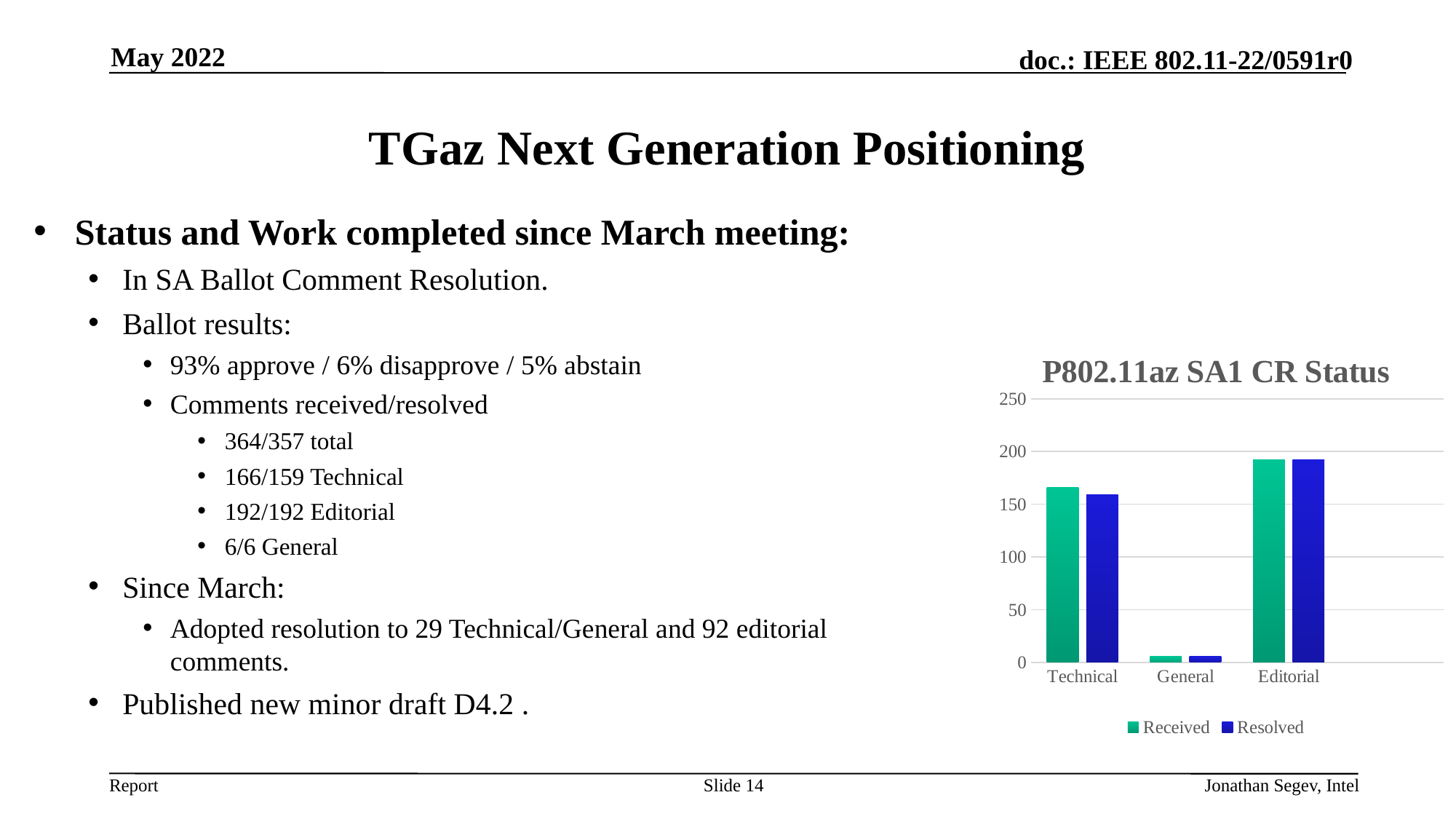
Which category has the lowest Resolved value? General What is the title of the chart? P802.11az SA1 CR Status Which is larger, the Received value for Technical or the Received value for Editorial? Editorial Which category has the highest Received value? Editorial Is the Received value for Technical greater or less than 150? greater How many categories are shown on the x axis of the chart? 3 How many series does the chart legend list? 2 Is the Received value for Editorial greater or less than 200? less Is the Resolved value for Editorial greater or less than 150? greater Which series is shown in dark blue in the chart? Resolved What type of chart is shown on the slide? bar chart